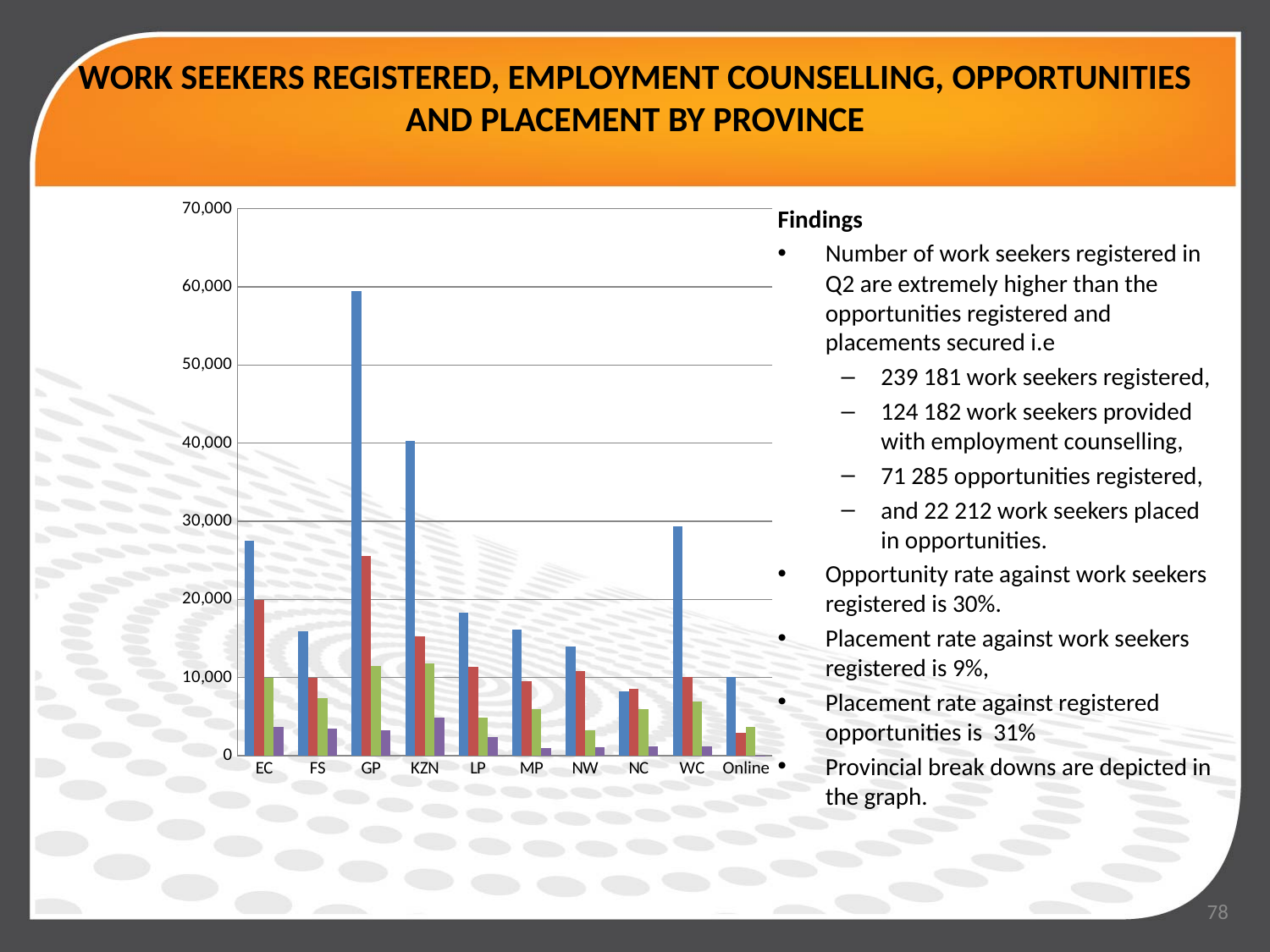
Is the value of the blue bar for FS greater or less than 10,000? greater Is the value of the blue bar for EC greater or less than 30,000? less Which has the larger blue bar, KZN or WC? KZN Which category has the shortest blue bar in the chart? NC How many categories are shown along the x axis of the chart? 10 What is the last category label on the x axis of the chart? Online Which category has the tallest blue bar in the chart? GP Which has the larger blue bar, EC or FS? EC Is the value of the blue bar for GP greater or less than 50,000? greater What kind of chart is shown on the slide? bar chart